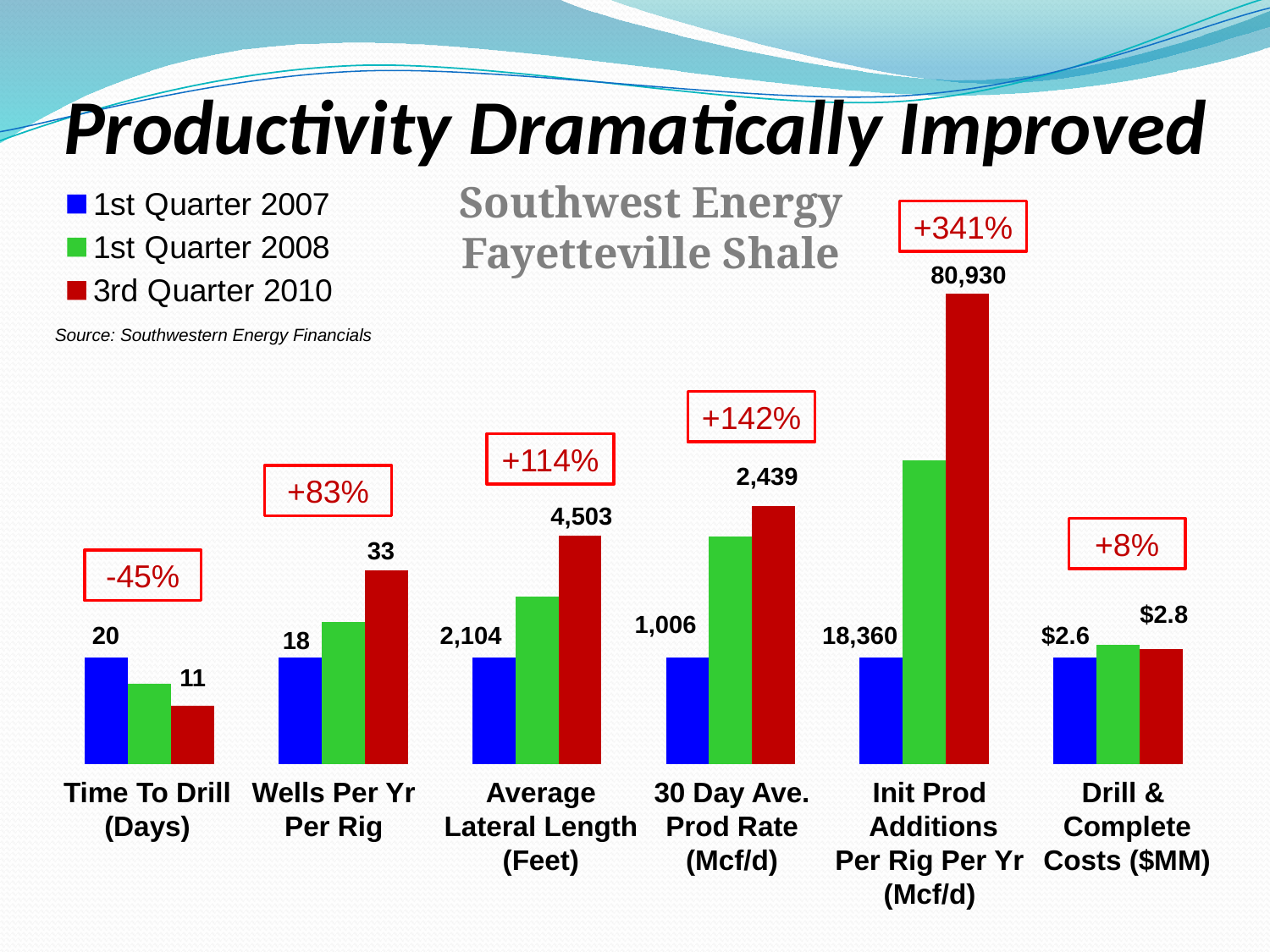
In the Time To Drill (Days) category, which is larger: the 1st Quarter 2007 value or the 3rd Quarter 2010 value? 1st Quarter 2007 What is the value for 1st Quarter 2007 in the Time To Drill (Days) category? 20 What is the value for 1st Quarter 2007 in the Drill & Complete Costs ($MM) category? $2.6 How many series does the legend list? 3 What percentage change is shown in the box above the Init Prod Additions Per Rig Per Yr (Mcf/d) category? +341% In the Wells Per Yr Per Rig category, what is the difference between the 3rd Quarter 2010 value and the 1st Quarter 2007 value? 15 What is the value for 1st Quarter 2007 in the Average Lateral Length (Feet) category? 2,104 How many categories are shown on the x axis of the chart? 6 What is the value for 3rd Quarter 2010 in the 30 Day Ave. Prod Rate (Mcf/d) category? 2,439 What kind of chart is shown on the slide? bar chart What is the value for 3rd Quarter 2010 in the Wells Per Yr Per Rig category? 33 What is the value for 3rd Quarter 2010 in the Init Prod Additions Per Rig Per Yr (Mcf/d) category? 80,930